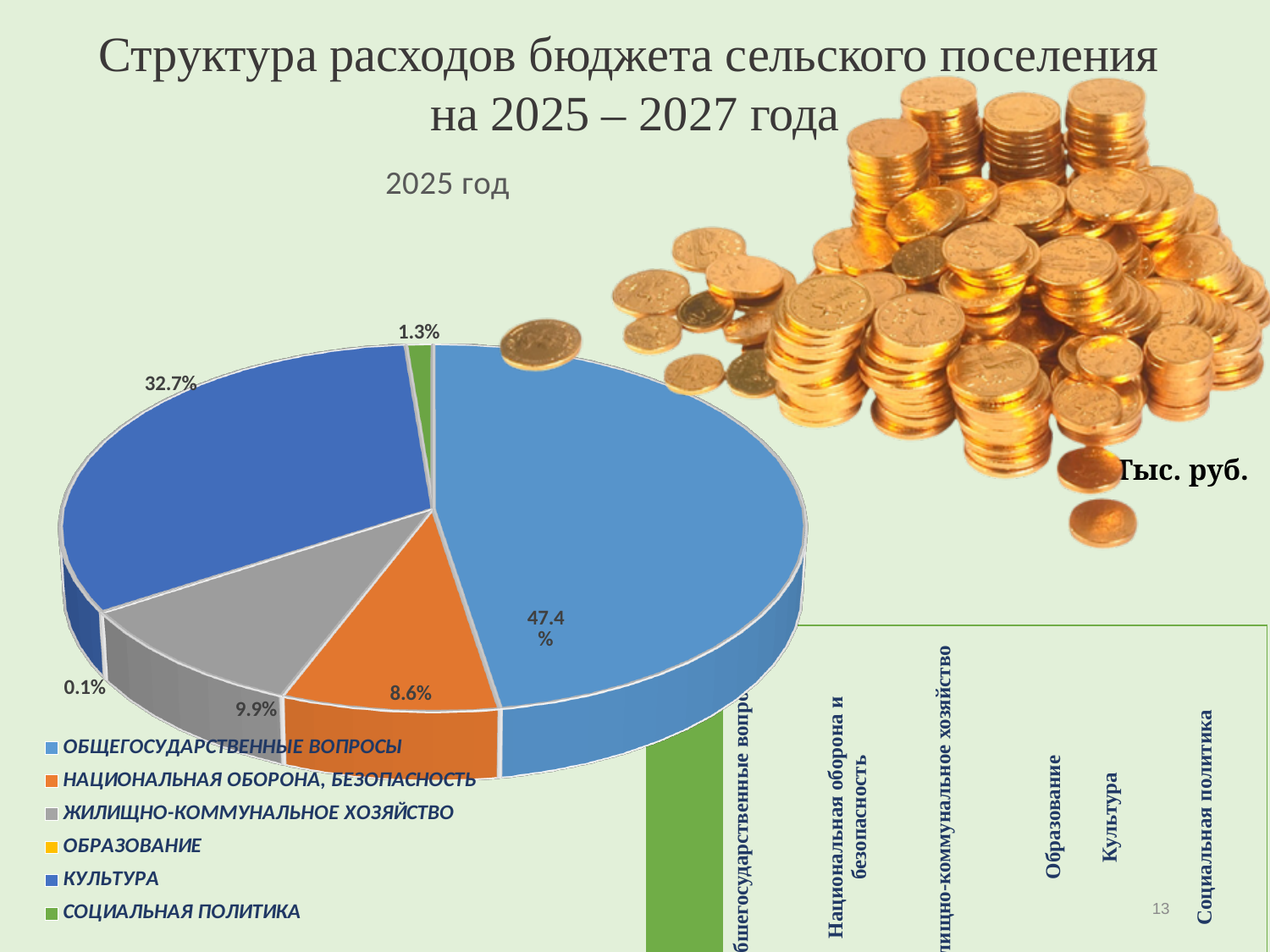
What share of the 2025 pie chart is НАЦИОНАЛЬНАЯ ОБОРОНА, БЕЗОПАСНОСТЬ? 8.6% What share of the 2025 pie chart is ЖИЛИЩНО-КОММУНАЛЬНОЕ ХОЗЯЙСТВО? 9.9% Which category has the smallest slice in the 2025 pie chart? ОБРАЗОВАНИЕ What share of the 2025 pie chart is СОЦИАЛЬНАЯ ПОЛИТИКА? 1.3% What share of the 2025 pie chart is ОБЩЕГОСУДАРСТВЕННЫЕ ВОПРОСЫ? 47.4% Which category has the largest slice in the 2025 pie chart? ОБЩЕГОСУДАРСТВЕННЫЕ ВОПРОСЫ What share of the 2025 pie chart is КУЛЬТУРА? 32.7% How many categories does the legend of the 2025 pie chart list? 6 What share of the 2025 pie chart is ОБРАЗОВАНИЕ? 0.1% What type of chart is used to show the 2025 budget expenditure structure? Pie chart In the 2025 pie chart, what is the difference between the shares of ОБЩЕГОСУДАРСТВЕННЫЕ ВОПРОСЫ and КУЛЬТУРА? 14.7% In the 2025 pie chart, which is larger: ЖИЛИЩНО-КОММУНАЛЬНОЕ ХОЗЯЙСТВО or НАЦИОНАЛЬНАЯ ОБОРОНА, БЕЗОПАСНОСТЬ? ЖИЛИЩНО-КОММУНАЛЬНОЕ ХОЗЯЙСТВО